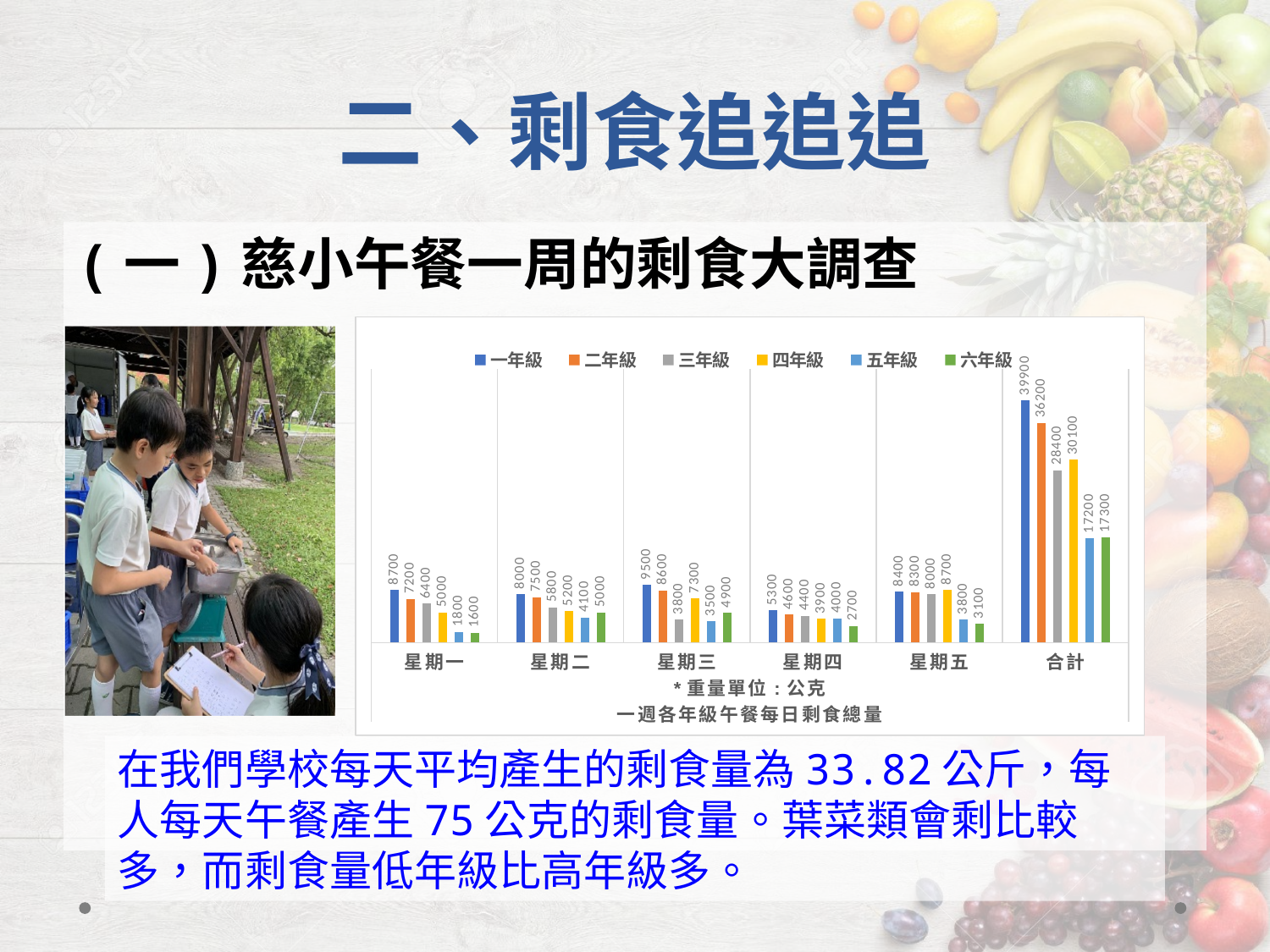
How many series does the legend list? 6 Which grade has the highest 合計 value? 一年級 What is the 合計 value for 四年級? 30100 What is the value for 一年級 on 星期三? 9500 How many categories are shown on the x axis? 6 Which grade has the lowest value on 星期一? 六年級 What is the title of the chart? 一週各年級午餐每日剩食總量 What is the value for 五年級 on 星期一? 1800 What type of chart is shown on the slide? bar chart What is the difference between the 合計 values of 一年級 and 二年級? 3700 What unit of weight does the chart note state? 公克 On 星期五, which is larger: the value for 四年級 or the value for 一年級? 四年級